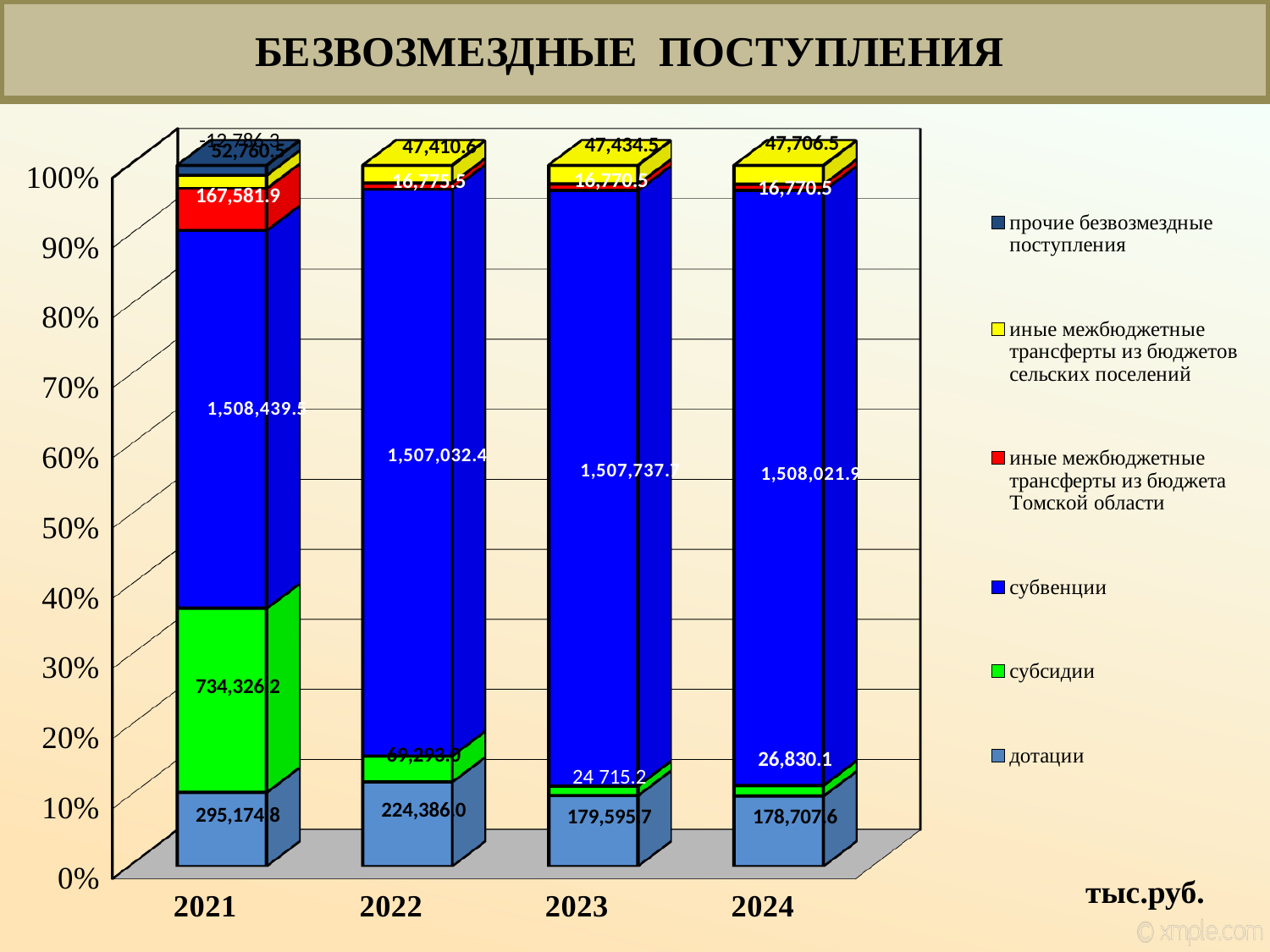
What is the value of дотации for 2023? 179,595.7 In which year is the value of дотации the highest? 2021 What is the difference between the дотации values for 2021 and 2022? 70,788.8 How many years are shown on the x axis? 4 What unit is stated for the values on the chart? тыс.руб. Which is larger, субсидии in 2023 or субсидии in 2024? 2024 How many series does the legend list? 6 What is the value of дотации for 2021? 295,174.8 What is the value of субсидии for 2021? 734,326.2 What is the value of субвенции for 2024? 1,508,021.9 What kind of chart is shown on the slide? bar chart What is the value of иные межбюджетные трансферты из бюджетов сельских поселений for 2024? 47,706.5